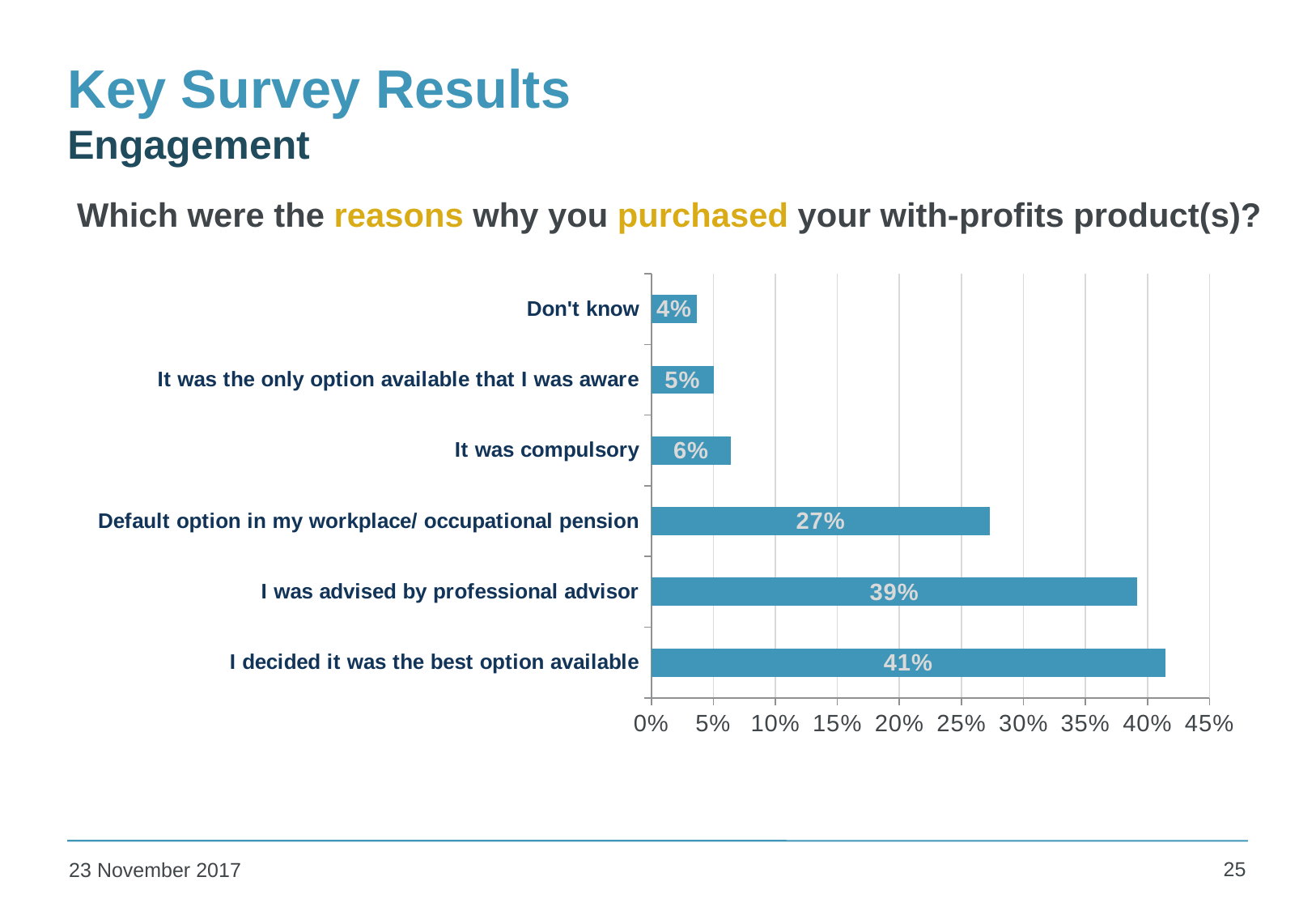
What is the difference between 'I was advised by professional advisor' and 'Default option in my workplace/ occupational pension'? 12% What is the value for 'Default option in my workplace/ occupational pension'? 27% Which reason has the lowest percentage? Don't know Which reason has the highest percentage? I decided it was the best option available Which is larger: 'It was compulsory' or 'It was the only option available that I was aware'? It was compulsory What percentage of respondents answered 'Don't know'? 4% What is the difference between 'It was compulsory' and 'Don't know'? 2% How many reasons are shown in the chart? 6 What kind of chart is shown on the slide? Bar chart What is the highest value shown on the x axis? 45% What percentage of respondents said they were advised by a professional advisor? 39% What percentage of respondents said they decided it was the best option available? 41%